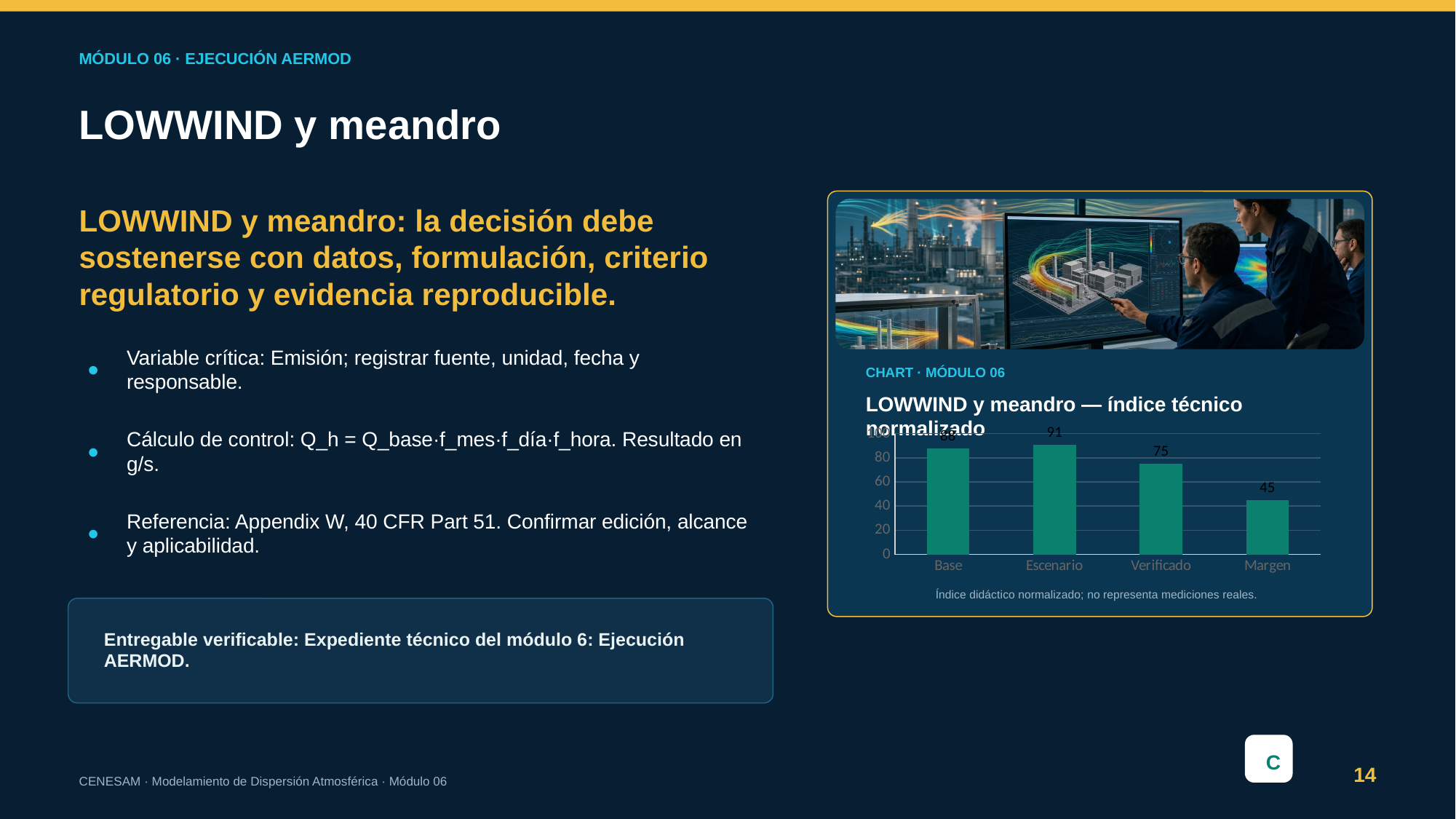
What is the value for Escenario? 91 What is the title of the chart? LOWWIND y meandro — índice técnico normalizado What kind of chart is shown on the slide? bar chart Which is larger, the value for Verificado or the value for Margen? Verificado Which category has the lowest value? Margen Is the value for Margen greater or less than 60? less Which category has the highest value? Escenario What is the difference between the values for Verificado and Margen? 30 What is the difference between the values for Escenario and Verificado? 16 What is the value for Margen? 45 How many categories are shown on the x axis? 4 What is the value for Verificado? 75